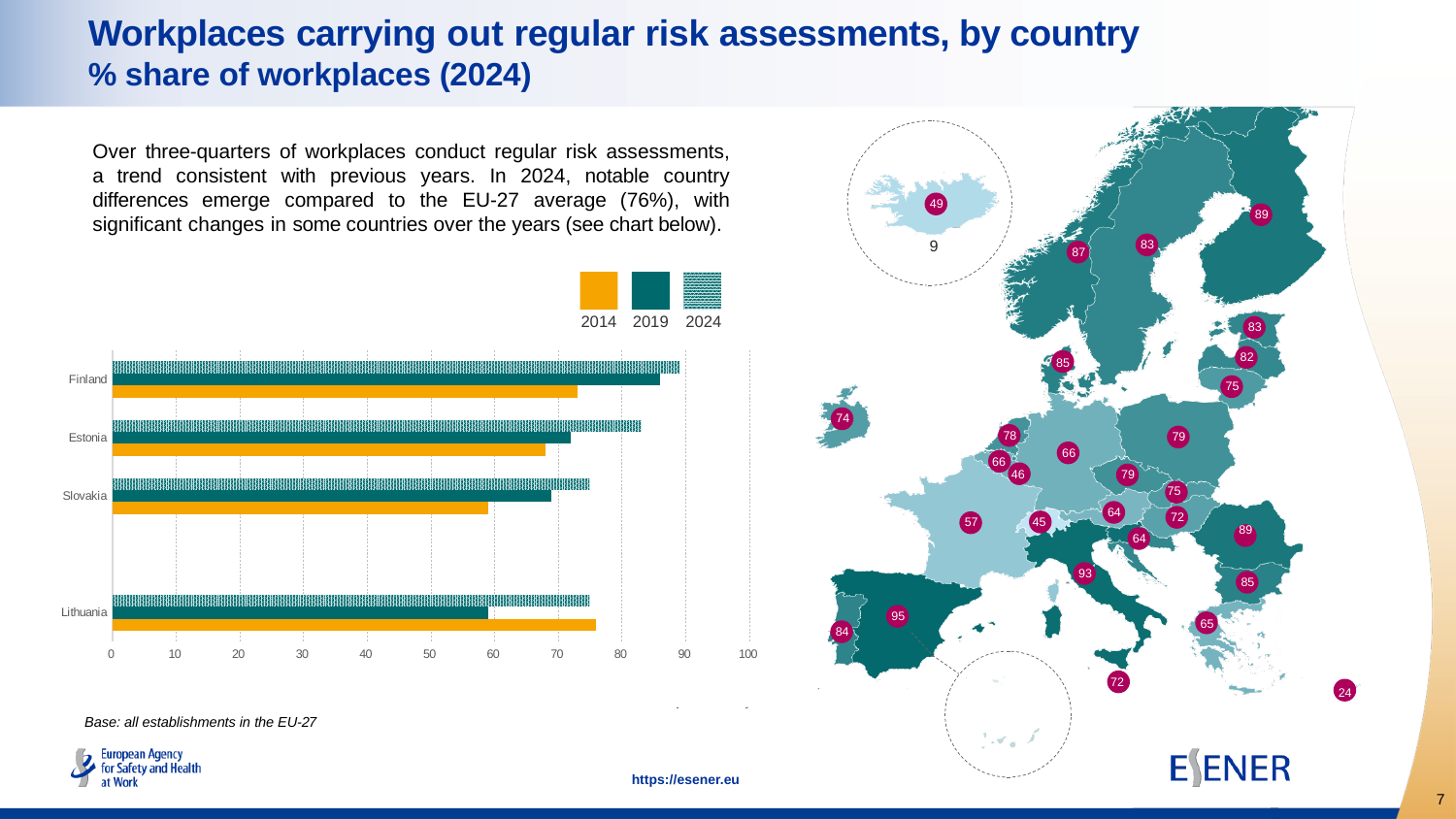
How many series does the legend of the bar chart list? 3 On the bar chart, which is larger for Lithuania: the 2014 value or the 2019 value? 2014 On the bar chart, is the 2014 value for Slovakia greater or less than 70? less On the bar chart, which country has the highest 2024 value? Finland Which years are listed in the legend of the bar chart? 2014, 2019, 2024 On the map, what value is shown for Spain? 95 What kind of chart is shown on the left of the slide? bar chart On the bar chart, which country has the lowest 2014 value? Slovakia How many countries are shown on the bar chart? 4 On the bar chart, is the 2019 value for Lithuania greater or less than 70? less On the bar chart, is the 2024 value for Finland greater or less than 80? greater On the bar chart, which is larger: the 2024 value for Finland or the 2024 value for Estonia? Finland